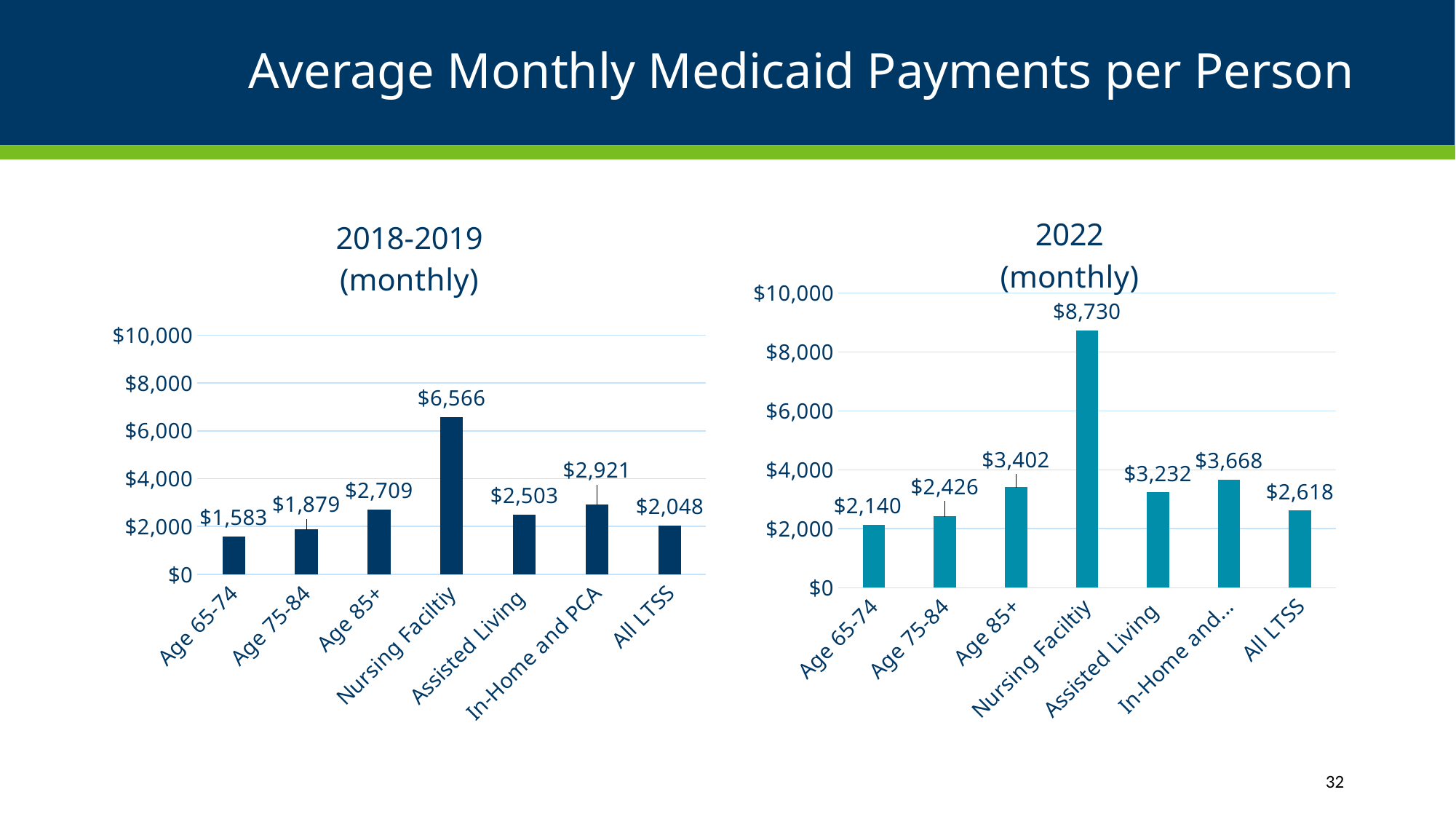
How many categories are shown in the 2018-2019 (monthly) chart? 7 In the 2022 (monthly) chart, what is the difference between Age 75-84 and Age 65-74? $286 In the 2022 (monthly) chart, what is the value for Assisted Living? $3,232 In the 2022 (monthly) chart, what is the difference between Nursing Facility and All LTSS? $6,112 What is the title of the slide? Average Monthly Medicaid Payments per Person In the 2022 (monthly) chart, is the value for Age 85+ greater or less than $4,000? less In the 2018-2019 (monthly) chart, which category has the lowest value? Age 65-74 What kind of chart is the 2022 (monthly) chart? bar chart In the 2018-2019 (monthly) chart, which is larger: In-Home and PCA or Assisted Living? In-Home and PCA In the 2018-2019 (monthly) chart, what is the value for Age 75-84? $1,879 In the 2022 (monthly) chart, which category has the highest value? Nursing Facility In the 2018-2019 (monthly) chart, what is the value for Nursing Facility? $6,566